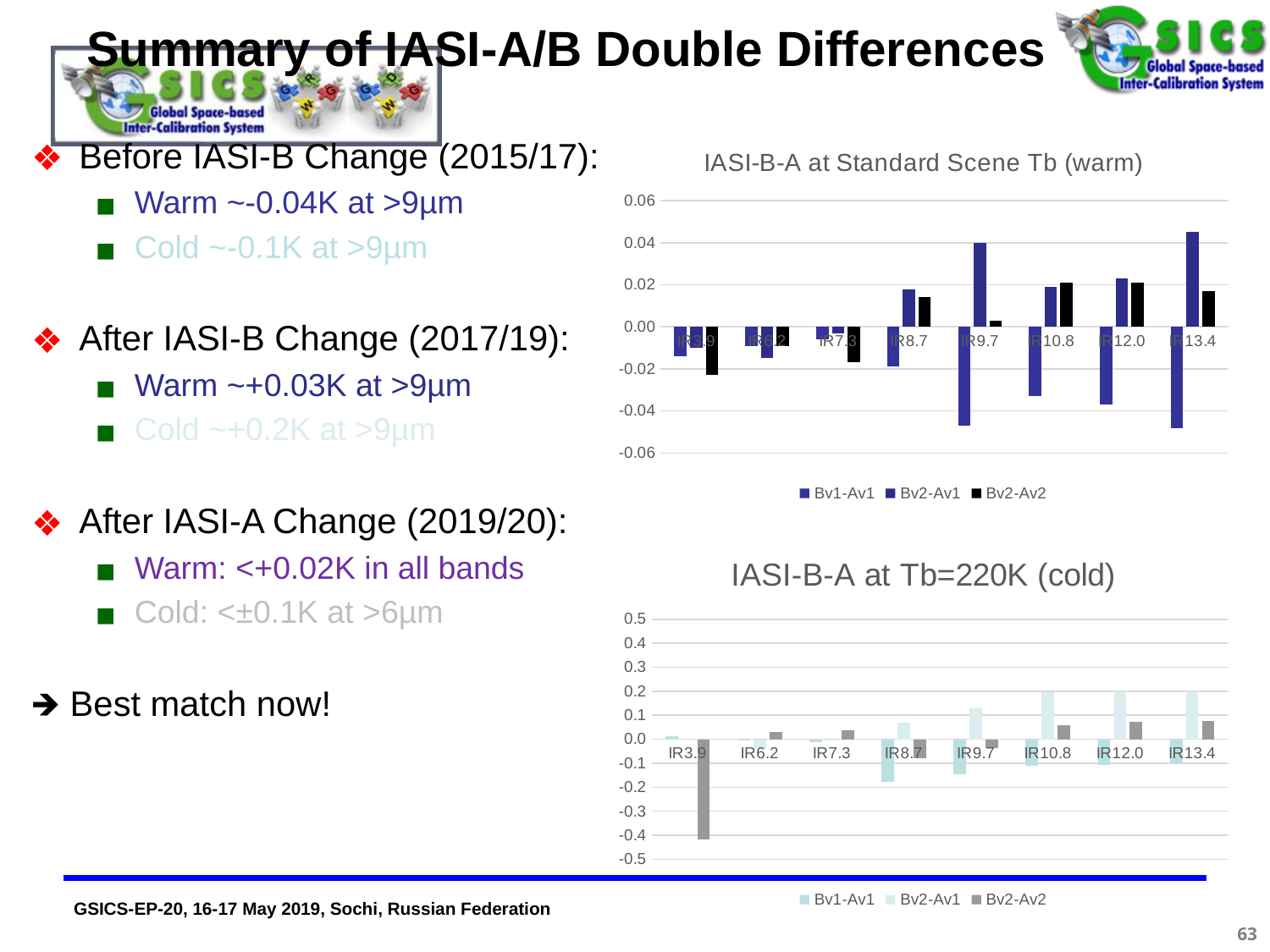
In the 'IASI-B-A at Tb=220K (cold)' chart, which category has the lowest Bv2-Av2 value? IR3.9 In the 'IASI-B-A at Standard Scene Tb (warm)' chart, is the Bv2-Av1 value for IR13.4 greater or less than 0.02? greater What is the title of the upper chart on the slide? IASI-B-A at Standard Scene Tb (warm) In the 'IASI-B-A at Tb=220K (cold)' chart, is the Bv2-Av1 value for IR10.8 greater or less than 0.1? greater In the 'IASI-B-A at Standard Scene Tb (warm)' chart, is the Bv1-Av1 value for IR9.7 greater or less than -0.02? less How many series does the legend of the 'IASI-B-A at Standard Scene Tb (warm)' chart list? 3 How many categories are shown on the x axis of the 'IASI-B-A at Tb=220K (cold)' chart? 8 What is the name of the third series in the legend of the 'IASI-B-A at Tb=220K (cold)' chart? Bv2-Av2 What kind of chart is the 'IASI-B-A at Standard Scene Tb (warm)' chart? bar chart In the 'IASI-B-A at Standard Scene Tb (warm)' chart, which is larger, the Bv2-Av2 value for IR3.9 or for IR13.4? IR13.4 In the 'IASI-B-A at Tb=220K (cold)' chart, which is larger, the Bv2-Av1 value for IR3.9 or for IR10.8? IR10.8